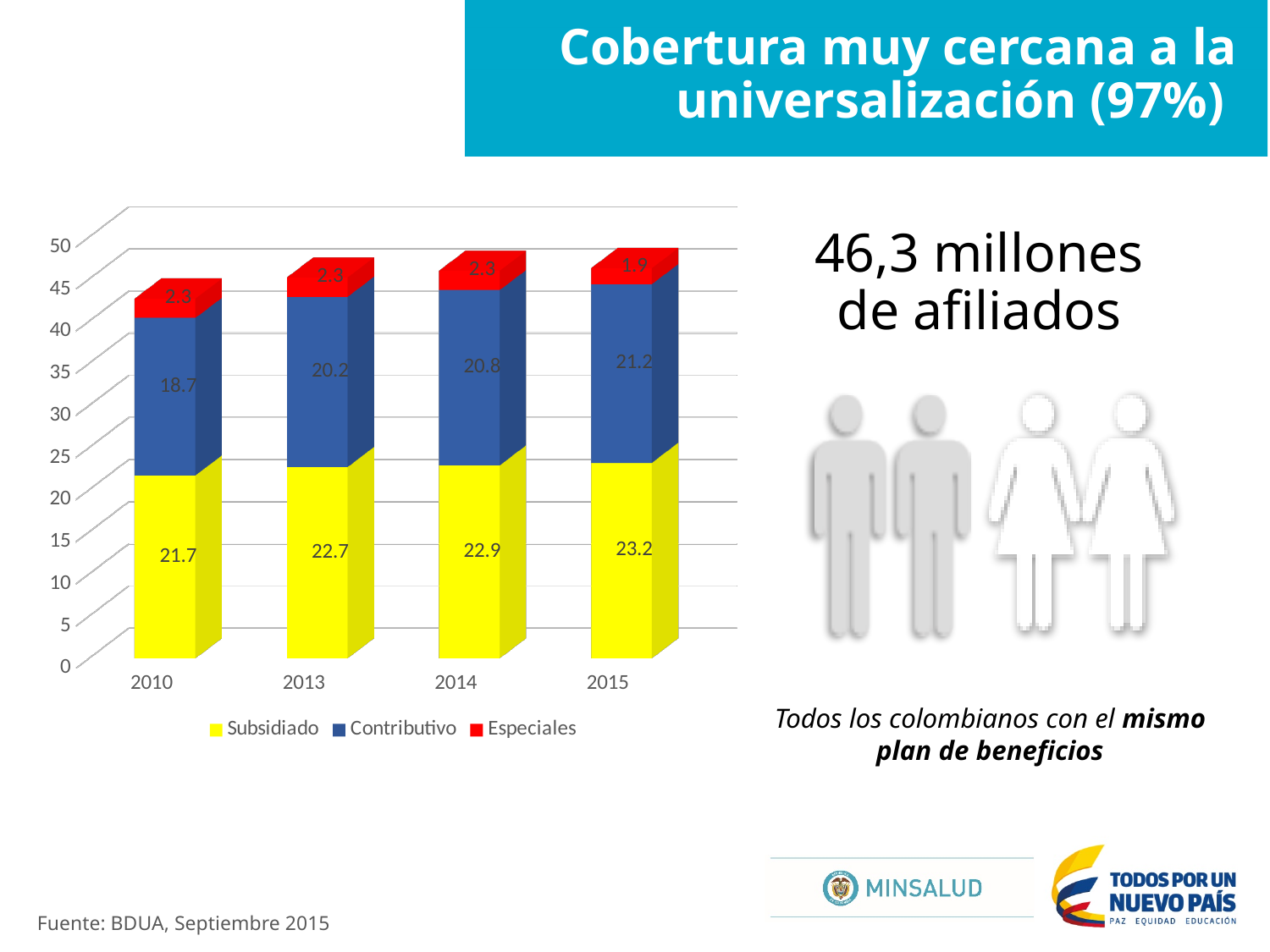
What is the Subsidiado value for 2015? 23.2 What is the Especiales value for 2015? 1.9 What is the total of the stacked bar for 2010? 42.7 How many series does the legend list? 3 What is the Contributivo value for 2010? 18.7 How many years are shown on the x axis? 4 What kind of chart is shown on the slide? Stacked bar chart What is the difference between the Contributivo values for 2015 and 2010? 2.5 What is the total of the stacked bar for 2015? 46.3 Which year has the highest Contributivo value? 2015 Which is larger, the Subsidiado value for 2014 or the Contributivo value for 2014? Subsidiado (22.9) Which year has the lowest Subsidiado value? 2010